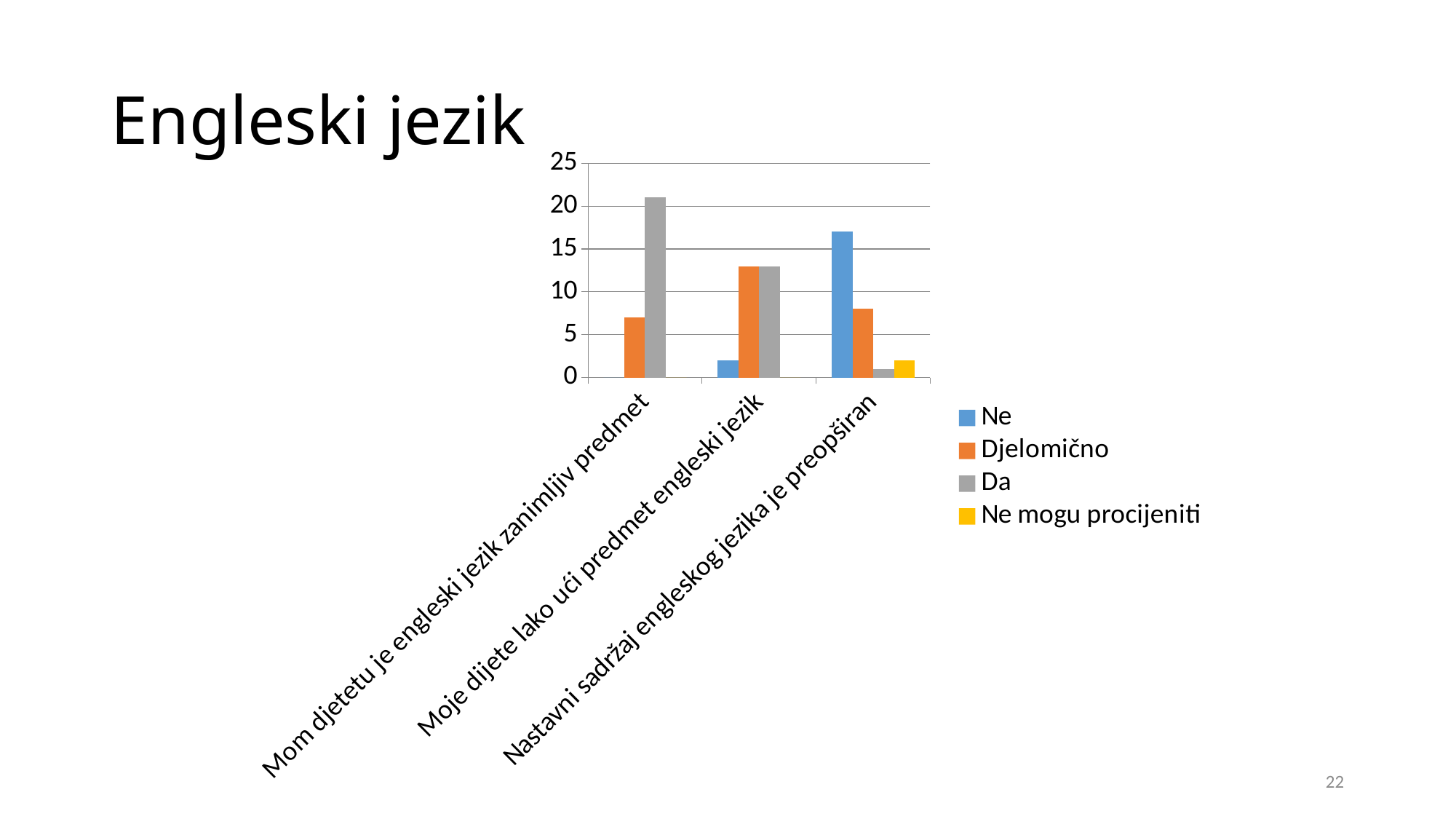
How many categories are shown on the x axis? 3 Is the value for "Ne" in the category "Moje dijete lako uči predmet engleski jezik" greater or less than 5? less Is the value for "Djelomično" in the category "Mom djetetu je engleski jezik zanimljiv predmet" greater or less than 10? less How many series does the legend list? 4 Is the value for "Ne" in the category "Nastavni sadržaj engleskog jezika je preopširan" greater or less than 15? greater Which series is shown in yellow in the legend? Ne mogu procijeniti Which series has the highest value in the category "Nastavni sadržaj engleskog jezika je preopširan"? Ne What kind of chart is shown on the slide? bar chart Which series has the highest value in the category "Mom djetetu je engleski jezik zanimljiv predmet"? Da What is the title of the slide containing the chart? Engleski jezik In the category "Nastavni sadržaj engleskog jezika je preopširan", which is larger: the value for "Ne" or the value for "Djelomično"? Ne